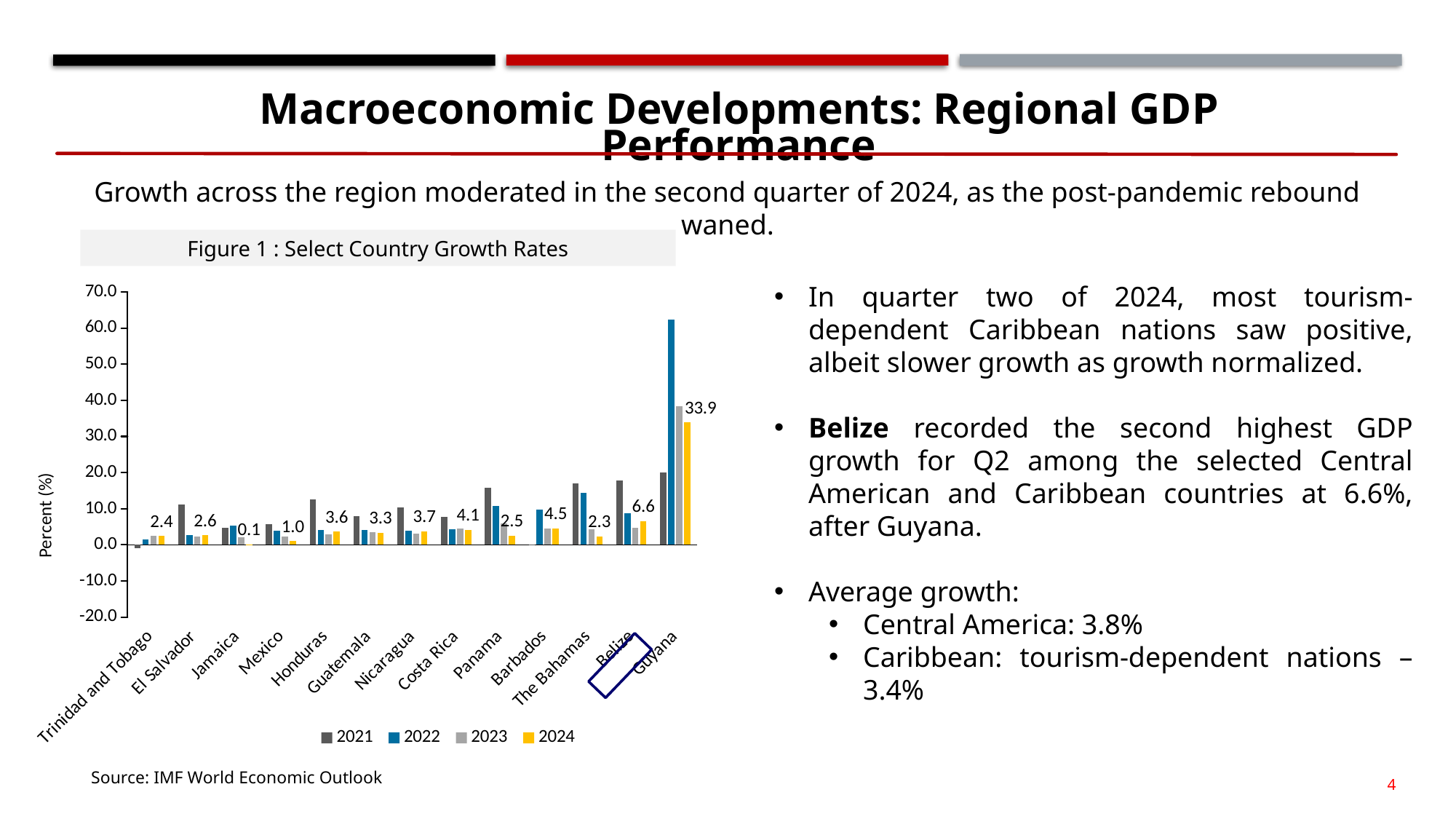
What is the 2024 growth rate for Guyana in Figure 1? 33.9 In Figure 1, what is the difference between the 2024 growth rates of Guyana and Belize? 27.3 How many countries are shown on the x axis of Figure 1? 13 What is the 2024 growth rate for Honduras in Figure 1? 3.6 What is the title of the chart on the slide? Figure 1 : Select Country Growth Rates In Figure 1, which has the larger 2024 growth rate, Barbados or Costa Rica? Barbados Which country has the lowest 2024 growth rate in Figure 1? Jamaica In Figure 1, is the 2022 value for Guyana greater or less than 50.0? greater What kind of chart is Figure 1: Select Country Growth Rates? bar chart Which country has the highest 2024 growth rate in Figure 1? Guyana How many series does the legend of Figure 1 list? 4 What is the 2024 growth rate for Belize in Figure 1? 6.6